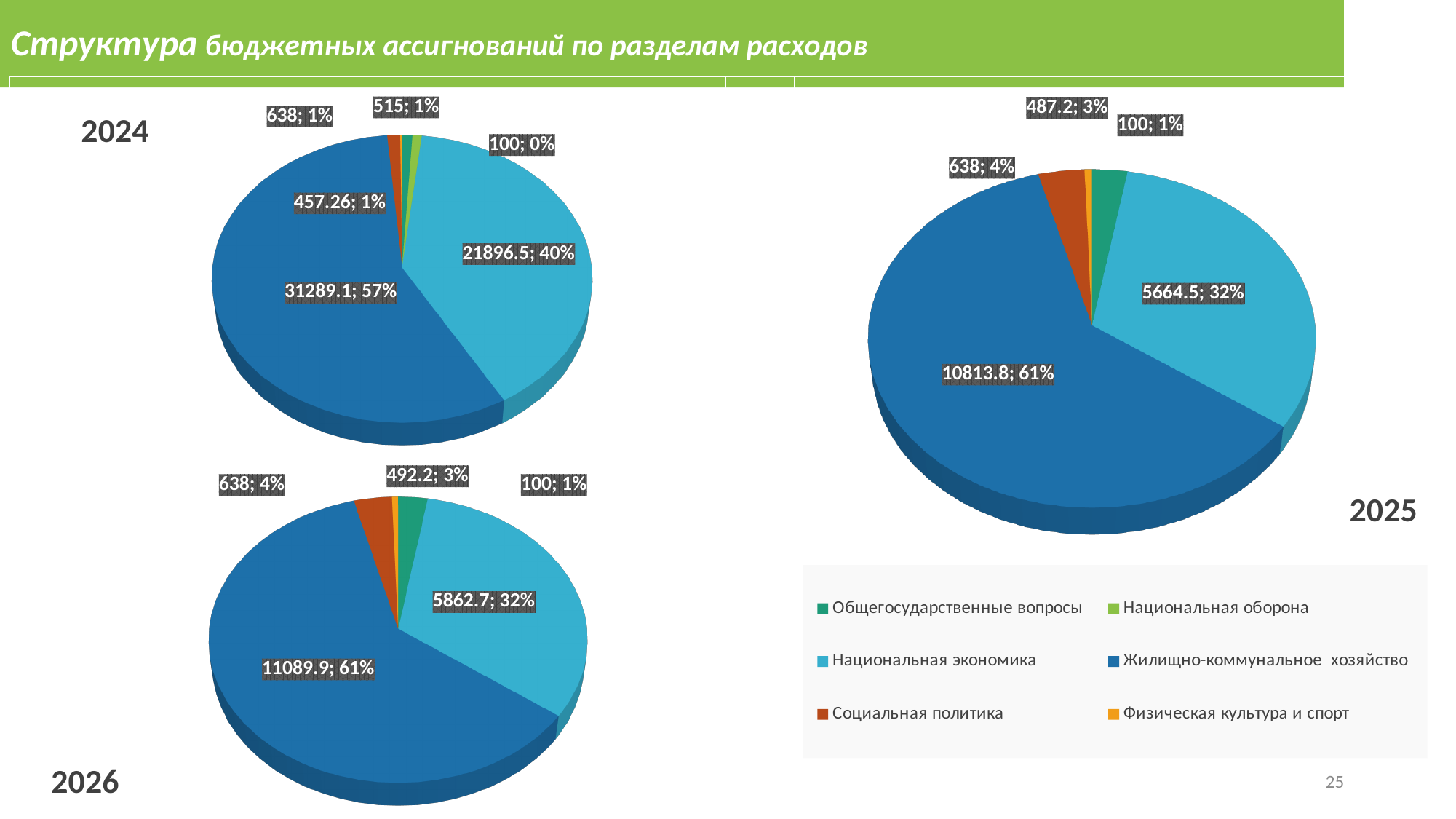
In the 2025 pie chart, what value is shown for Национальная экономика? 5664.5 How many categories does the legend on the slide list? 6 In the 2025 pie chart, which category has the largest slice? Жилищно-коммунальное хозяйство In the 2026 pie chart, what share does Социальная политика have? 4% What kind of chart is used for the 2024 data on this slide? pie chart In the 2026 pie chart, what is the difference between the values for Жилищно-коммунальное хозяйство and Национальная экономика? 5227.2 In the 2024 pie chart, which is larger: Жилищно-коммунальное хозяйство or Национальная экономика? Жилищно-коммунальное хозяйство In the 2024 pie chart, what value is shown for Жилищно-коммунальное хозяйство? 31289.1 In the 2024 pie chart, what share does Национальная экономика have? 40% In the 2026 pie chart, what value is shown for Жилищно-коммунальное хозяйство? 11089.9 How many slices does the 2025 pie chart have? 5 In the 2025 pie chart, what share does Жилищно-коммунальное хозяйство have? 61%